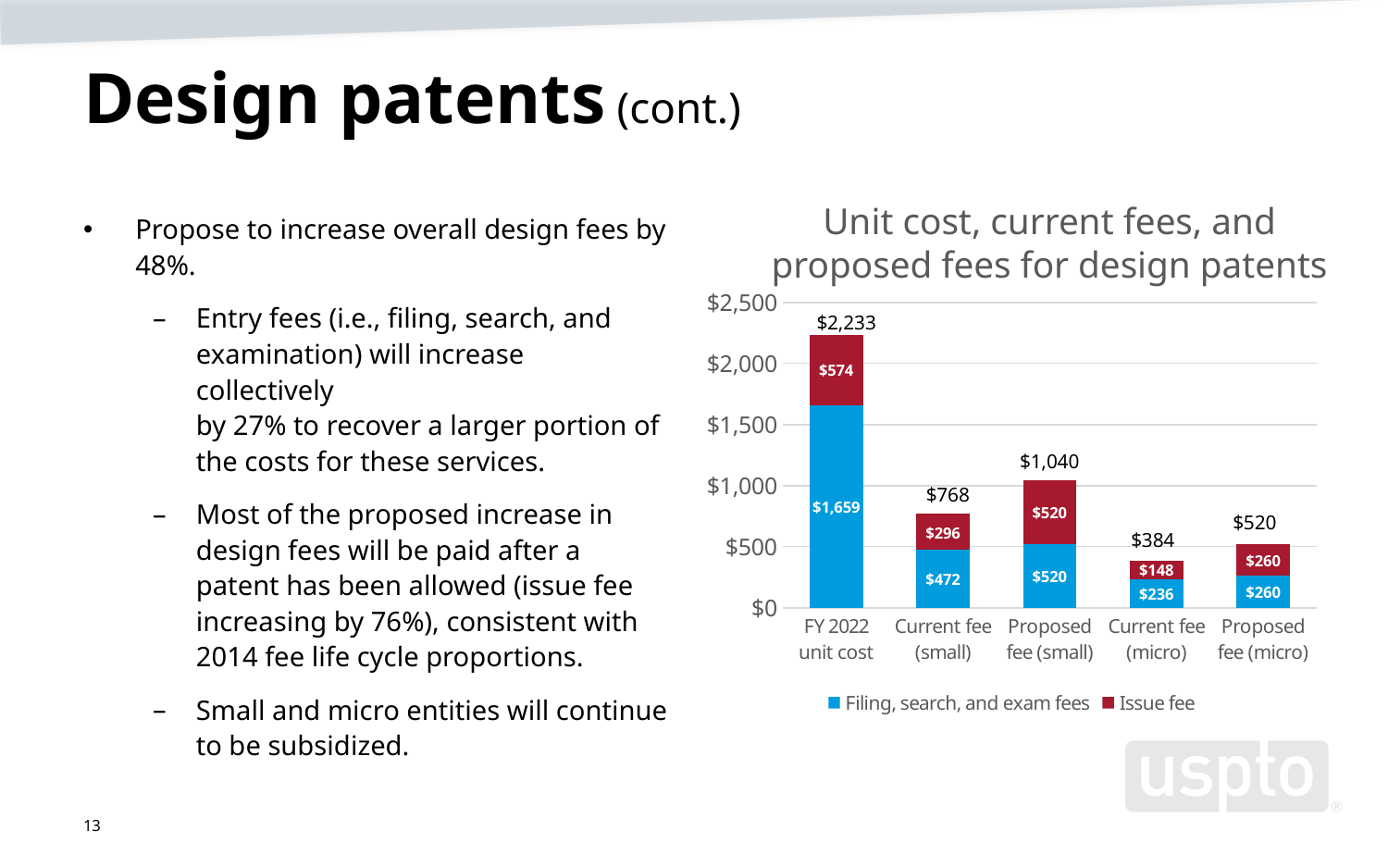
How many series does the legend list? 2 What is the Issue fee value for Proposed fee (micro)? $260 Which category has the lowest total? Current fee (micro) What is the total of the stacked bar for Proposed fee (small)? $1,040 What is the difference between the totals for Proposed fee (small) and Current fee (small)? $272 What kind of chart is shown? Stacked bar chart What is the total of the stacked bar for Current fee (micro)? $384 How many categories are shown on the x axis? 5 What is the Filing, search, and exam fees value for FY 2022 unit cost? $1,659 What is the Issue fee value for Current fee (small)? $296 Which category has the highest total? FY 2022 unit cost Which is larger, the Issue fee for FY 2022 unit cost or the Issue fee for Proposed fee (small)? FY 2022 unit cost